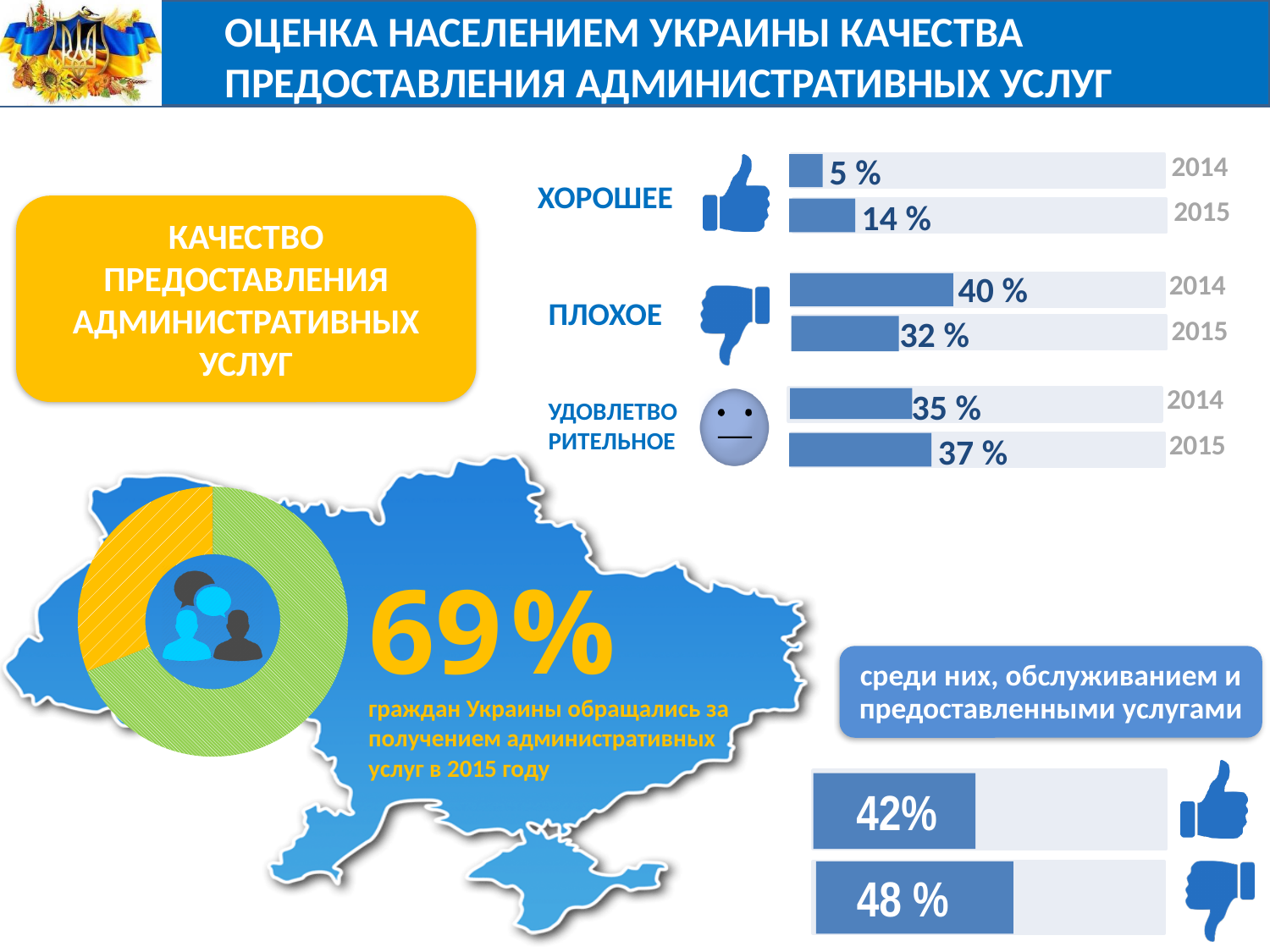
In the top-right bar chart on quality of administrative services, what is the value for ПЛОХОЕ in 2014? 40 % What share of Ukrainian citizens applied for administrative services in 2015, according to the donut chart on the map? 69% In the top-right bar chart on quality of administrative services, what is the difference between ПЛОХОЕ in 2014 and ПЛОХОЕ in 2015? 8 % In the top-right bar chart on quality of administrative services, which is larger: УДОВЛЕТВОРИТЕЛЬНОЕ in 2015 or ПЛОХОЕ in 2015? УДОВЛЕТВОРИТЕЛЬНОЕ in 2015 In the top-right bar chart on quality of administrative services, what is the value for УДОВЛЕТВОРИТЕЛЬНОЕ in 2015? 37 % In the top-right bar chart on quality of administrative services, what is the value for ХОРОШЕЕ in 2015? 14 % In the top-right bar chart on quality of administrative services, which category has the lowest value in 2014? ХОРОШЕЕ In the top-right bar chart on quality of administrative services, which category has the highest value in 2014? ПЛОХОЕ In the bottom-right bar chart on satisfaction with service, what is the value next to the thumbs-down icon? 48 % In the top-right bar chart on quality of administrative services, how many categories are shown? 3 In the top-right bar chart on quality of administrative services, by how many percentage points did ХОРОШЕЕ change from 2014 to 2015? 9 % In the top-right bar chart on quality of administrative services, did the value for ПЛОХОЕ rise or fall from 2014 to 2015? fall